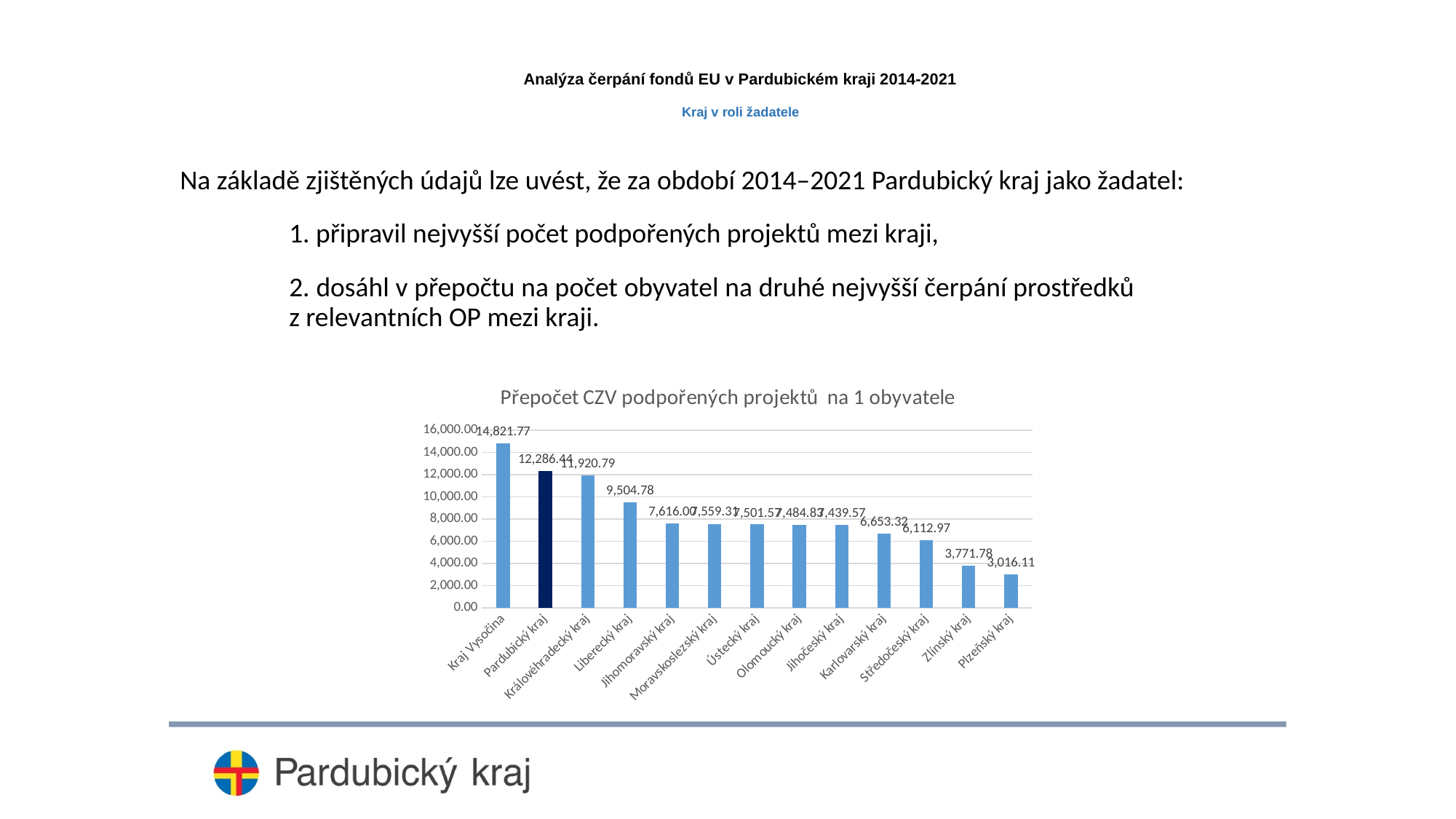
What is the value shown for Zlínský kraj? 3,771.78 What is the difference between the values for Kraj Vysočina and Pardubický kraj? 2,535.33 What is the value shown for Kraj Vysočina? 14,821.77 What is the value shown for Pardubický kraj? 12,286.44 How many regions are shown on the x axis of the chart? 13 What is the value shown for Liberecký kraj? 9,504.78 Which region's bar is drawn in a dark navy colour, unlike the others? Pardubický kraj Which region has the lowest value in the chart? Plzeňský kraj What type of chart is shown on the slide? bar chart Which has the larger value, Karlovarský kraj or Středočeský kraj? Karlovarský kraj Which region has the highest value in the chart? Kraj Vysočina Do the values rise or fall from left to right along the x axis? fall